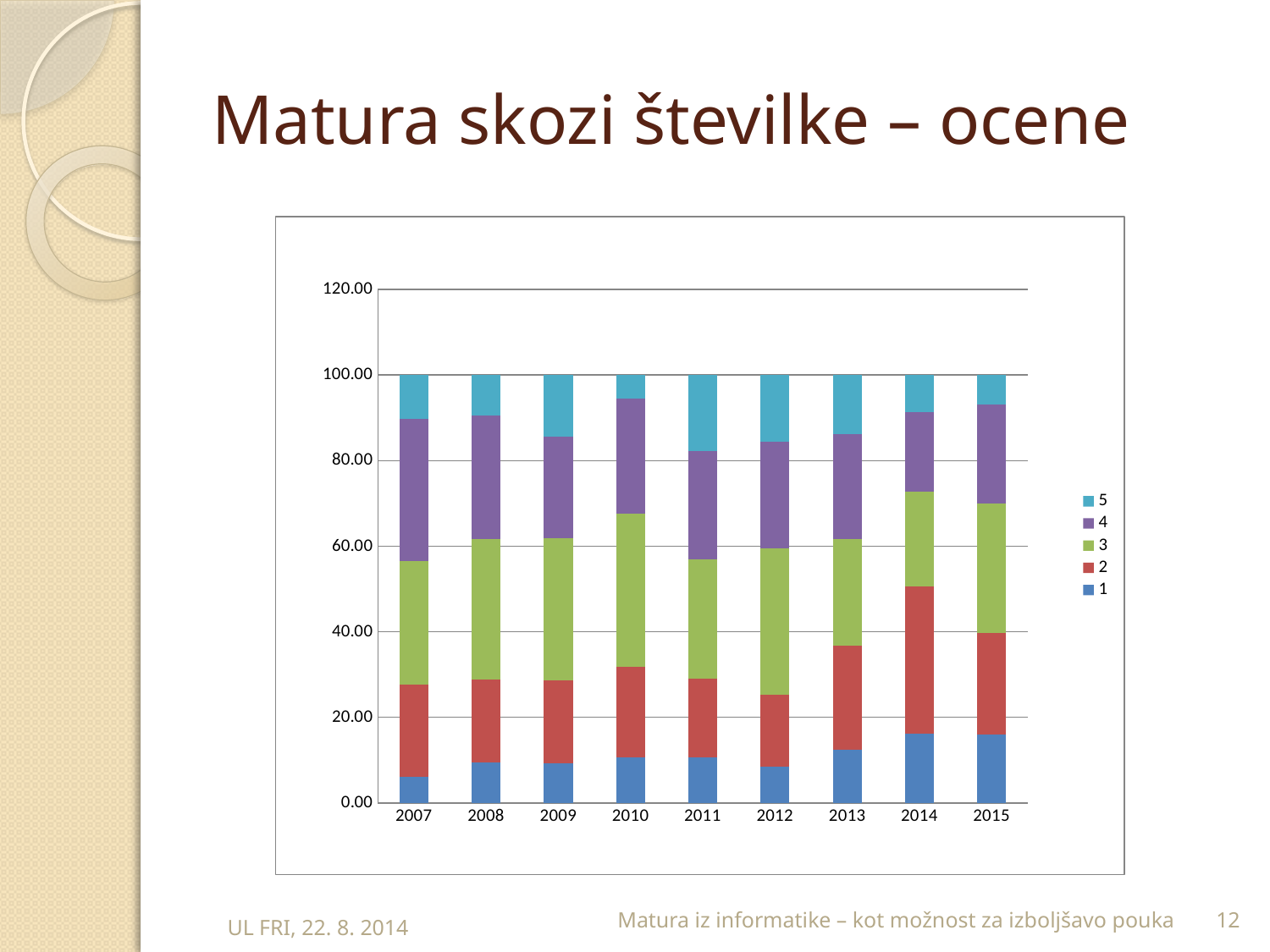
What is the total height of the stacked bar for 2007? 100.00 Is the series 3 segment larger in 2012 or in 2014? 2012 Is the cumulative top of series 2 for 2014 greater or less than 40.00? greater What is the title of the slide containing the chart? Matura skozi številke – ocene What is the total height of the stacked bar for 2015? 100.00 What kind of chart is shown on the slide? stacked bar chart Which year has the largest segment for series 2? 2014 Is the value of series 1 for 2007 greater or less than 20.00? less How many series does the chart legend list? 5 How many years are shown on the x axis of the chart? 9 Is the cumulative top of series 2 for 2012 greater or less than 40.00? less Is the series 1 segment larger in 2014 or in 2007? 2014